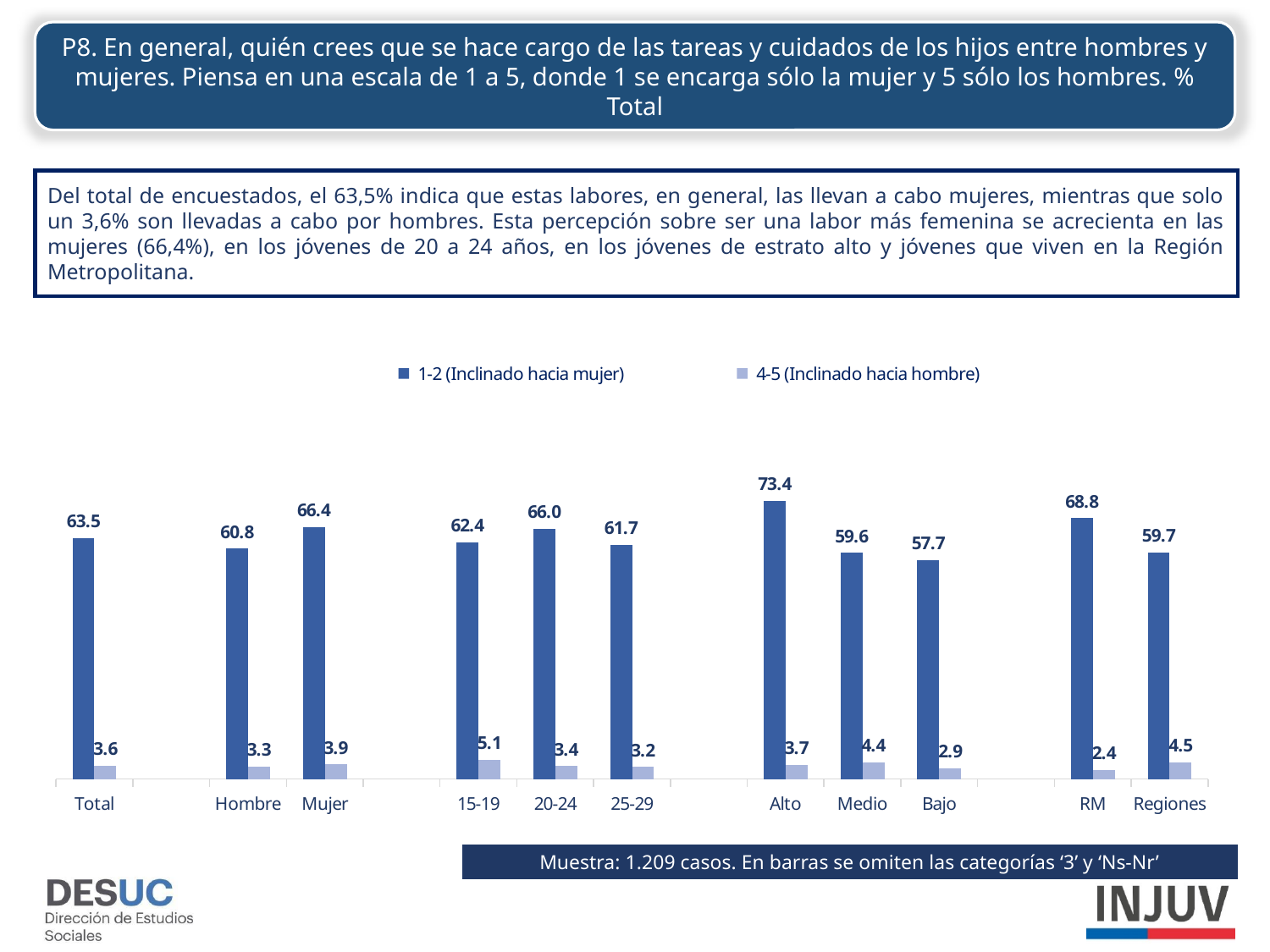
Which has a larger '1-2 (Inclinado hacia mujer)' value, RM or Regiones? RM What is the difference between the '1-2 (Inclinado hacia mujer)' values for Mujer and Hombre? 5.6 What is the difference between the '1-2 (Inclinado hacia mujer)' values for Alto and Bajo? 15.7 Which category has the highest value for '4-5 (Inclinado hacia hombre)'? 15-19 Which category has the lowest value for '4-5 (Inclinado hacia hombre)'? RM Which category has the highest value for '1-2 (Inclinado hacia mujer)'? Alto How many categories are shown on the x axis? 11 What is the value of '1-2 (Inclinado hacia mujer)' for Total? 63.5 What kind of chart is shown on the slide? Bar chart What is the value of '1-2 (Inclinado hacia mujer)' for Alto? 73.4 How many series does the legend list? 2 What is the value of '4-5 (Inclinado hacia hombre)' for Mujer? 3.9